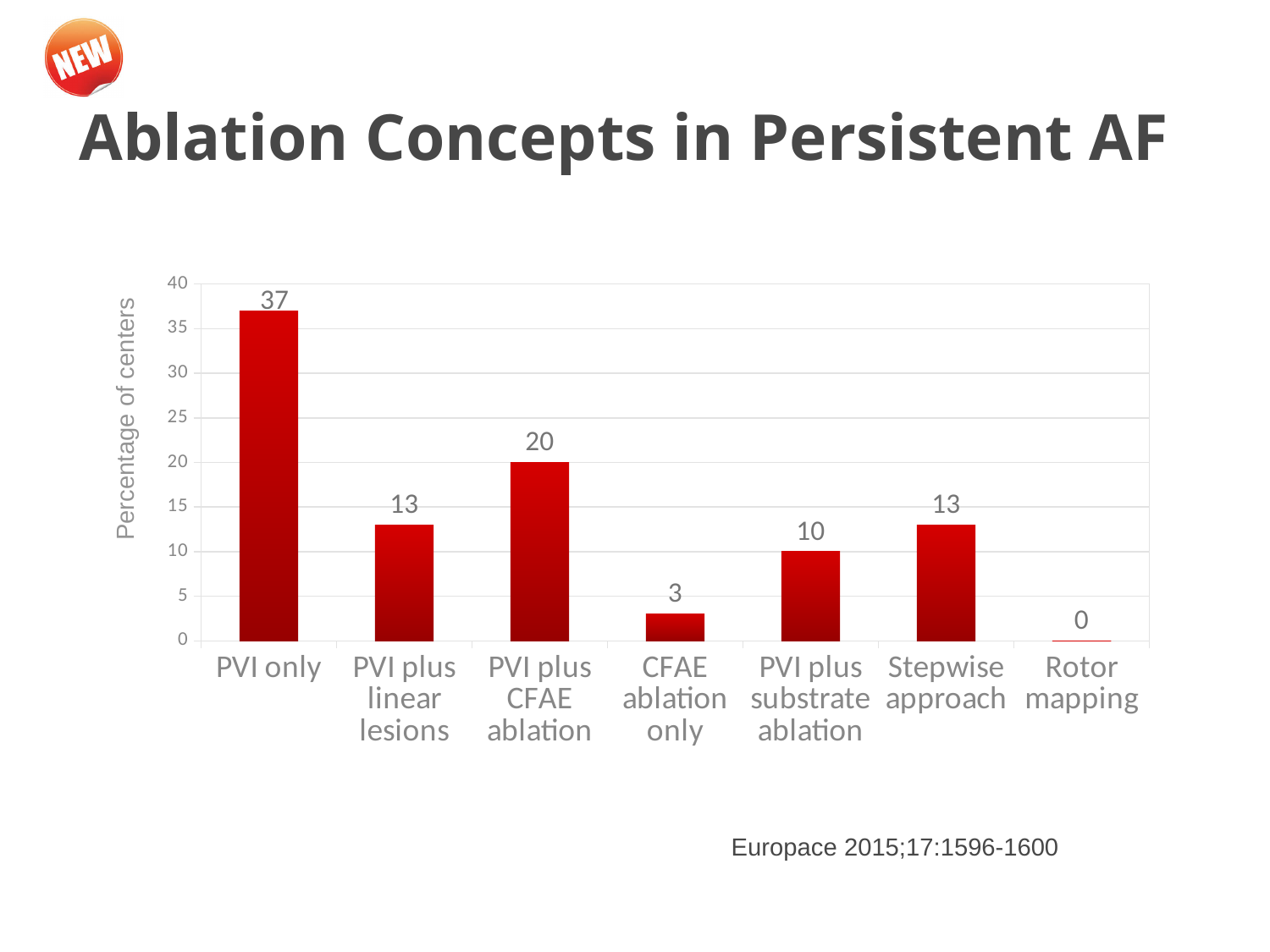
Which is larger, the value for PVI plus substrate ablation or the value for Stepwise approach? Stepwise approach Is the value for PVI plus linear lesions greater or less than 10? greater Which category has the lowest value? Rotor mapping What kind of chart is shown on the slide? bar chart What is the label of the vertical axis? Percentage of centers What is the value for PVI only? 37 What is the value for PVI plus CFAE ablation? 20 Which category has the highest value? PVI only What is the value for Rotor mapping? 0 What is the difference between the values for PVI only and PVI plus CFAE ablation? 17 What is the value for CFAE ablation only? 3 How many categories are shown on the x axis? 7